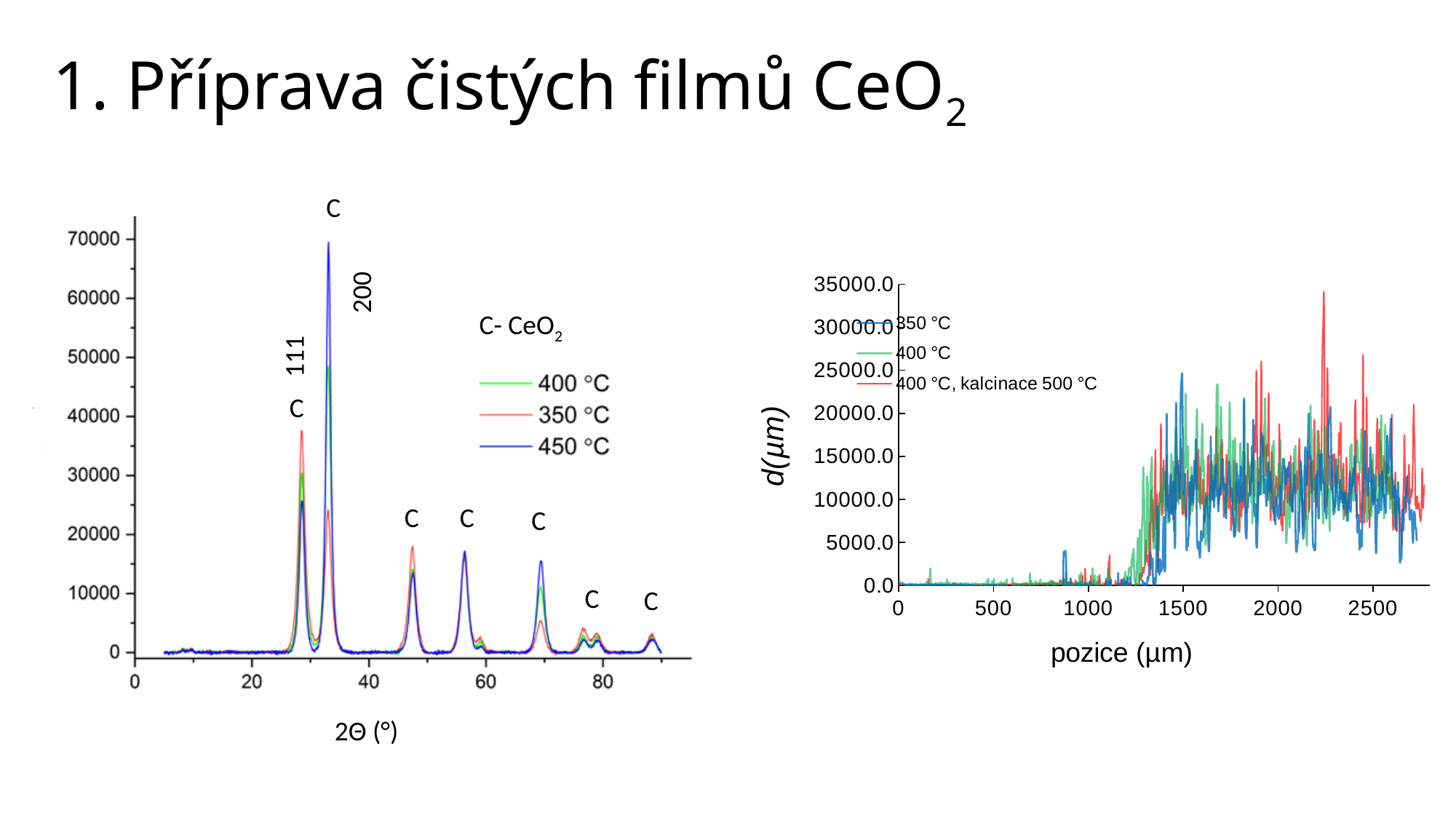
In the right chart, do the values rise or fall as the position increases from 0 to 2500 µm? rise In the right chart, which series reaches the highest single peak (near position 2250 µm)? 400 °C, kalcinace 500 °C In the left chart, is the tallest peak of the 450 °C series greater or less than 60000? greater In the left chart, how many peaks are marked with the letter C? 7 In the left chart, which Miller index label is placed next to the tallest peak? 200 What kind of chart is the left chart (2Θ (°) on the x axis)? line chart What is the x-axis label of the right chart? pozice (µm) How many series does the legend of the right chart list? 3 In the right chart, is the value of the 350 °C series at position 500 µm greater or less than 5000.0? less What kind of chart is the right chart (pozice (µm) on the x axis)? line chart In the left chart, which series has the highest peak near 2Θ = 33°? 450 °C How many series does the legend of the left chart list? 3